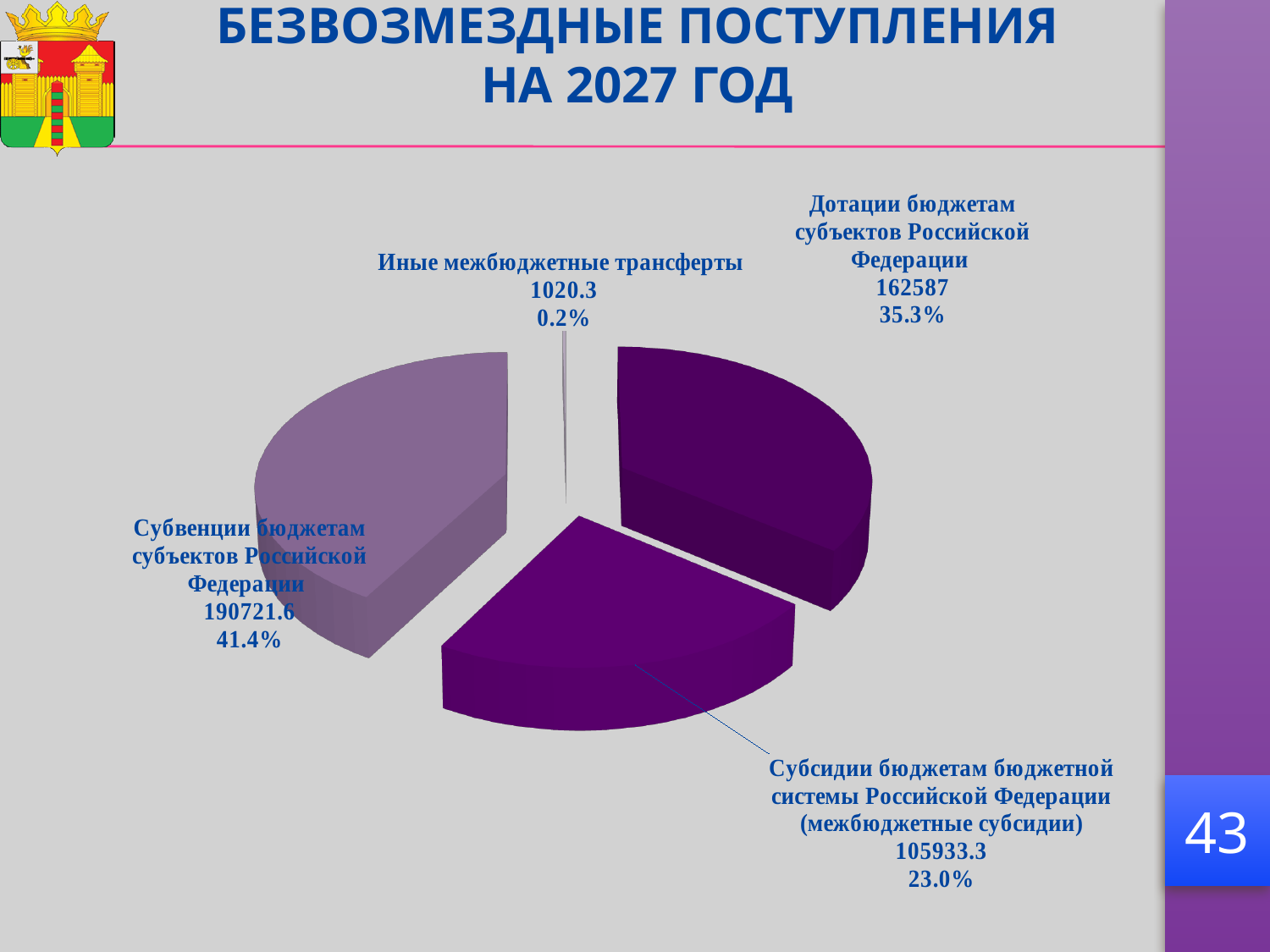
How many slices does the pie chart have? 4 What kind of chart is shown on the slide? Pie chart What is the value for Субсидии бюджетам бюджетной системы Российской Федерации (межбюджетные субсидии)? 105933.3 What share of the pie do Дотации бюджетам субъектов Российской Федерации represent? 35.3% Which is larger: the value for Дотации бюджетам субъектов Российской Федерации or the value for Субсидии бюджетам бюджетной системы Российской Федерации (межбюджетные субсидии)? Дотации бюджетам субъектов Российской Федерации What is the value for Субвенции бюджетам субъектов Российской Федерации? 190721.6 What share of the pie do Субсидии бюджетам бюджетной системы Российской Федерации (межбюджетные субсидии) represent? 23.0% Which category has the largest share of the pie? Субвенции бюджетам субъектов Российской Федерации What is the difference between the values for Субвенции бюджетам субъектов Российской Федерации and Дотации бюджетам субъектов Российской Федерации? 28134.6 What is the value for Дотации бюджетам субъектов Российской Федерации? 162587 What is the value for Иные межбюджетные трансферты? 1020.3 Which category has the smallest share of the pie? Иные межбюджетные трансферты